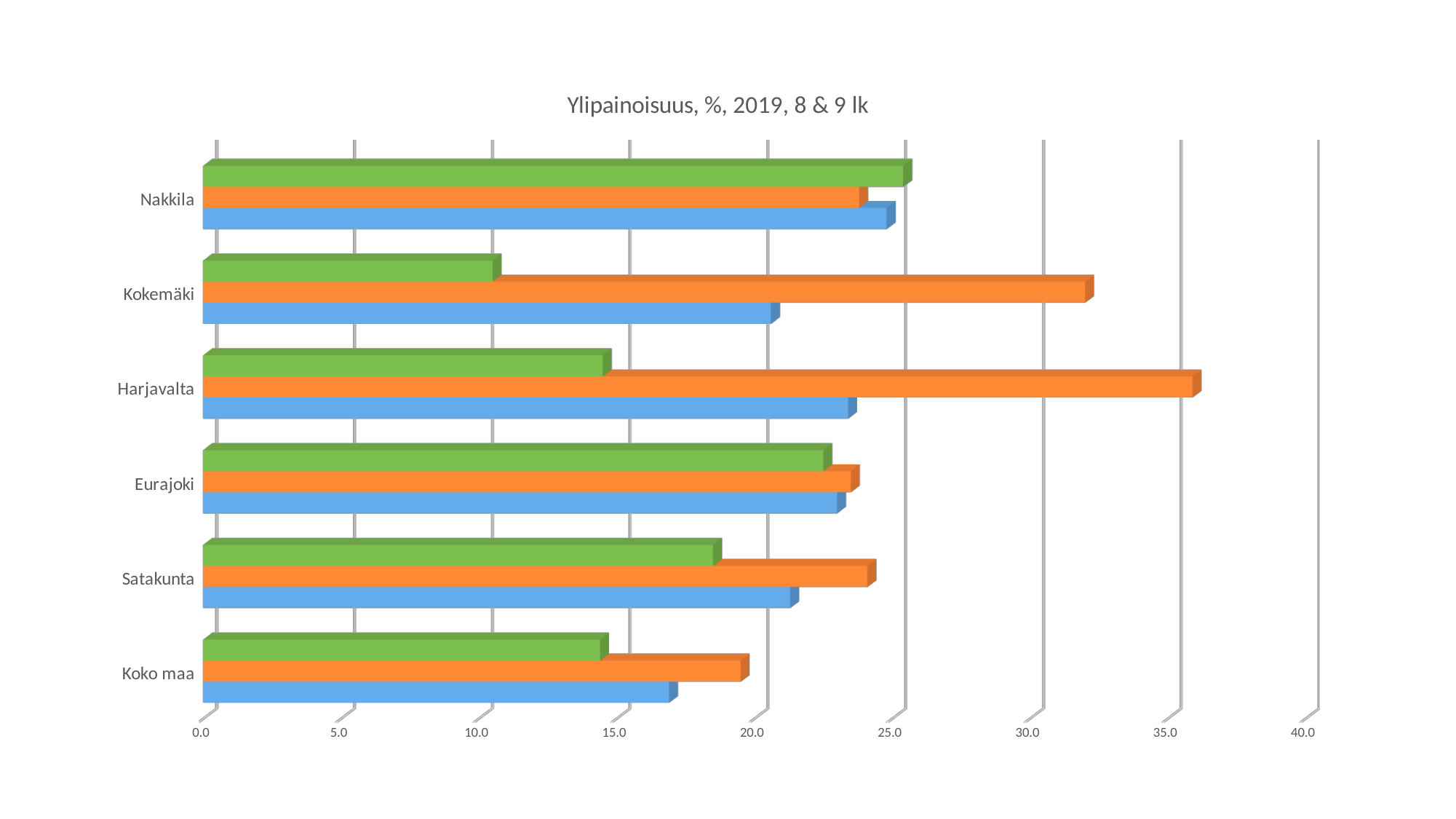
How many categories are shown on the vertical axis of the chart? 6 Is the green bar for Kokemäki greater or less than 15.0? less Which category has the shortest bar overall in the chart? Kokemäki What is the title of the chart? Ylipainoisuus, %, 2019, 8 & 9 lk Which category has the longest bar overall in the chart? Harjavalta Is the orange bar for Harjavalta greater or less than 35.0? greater Among the orange bars, which category has the lowest value? Koko maa What type of chart is shown on the slide? bar chart How many bars are shown for each category in the chart? 3 Is the blue bar for Koko maa greater or less than 15.0? greater For Kokemäki, which is larger: the orange bar or the green bar? the orange bar